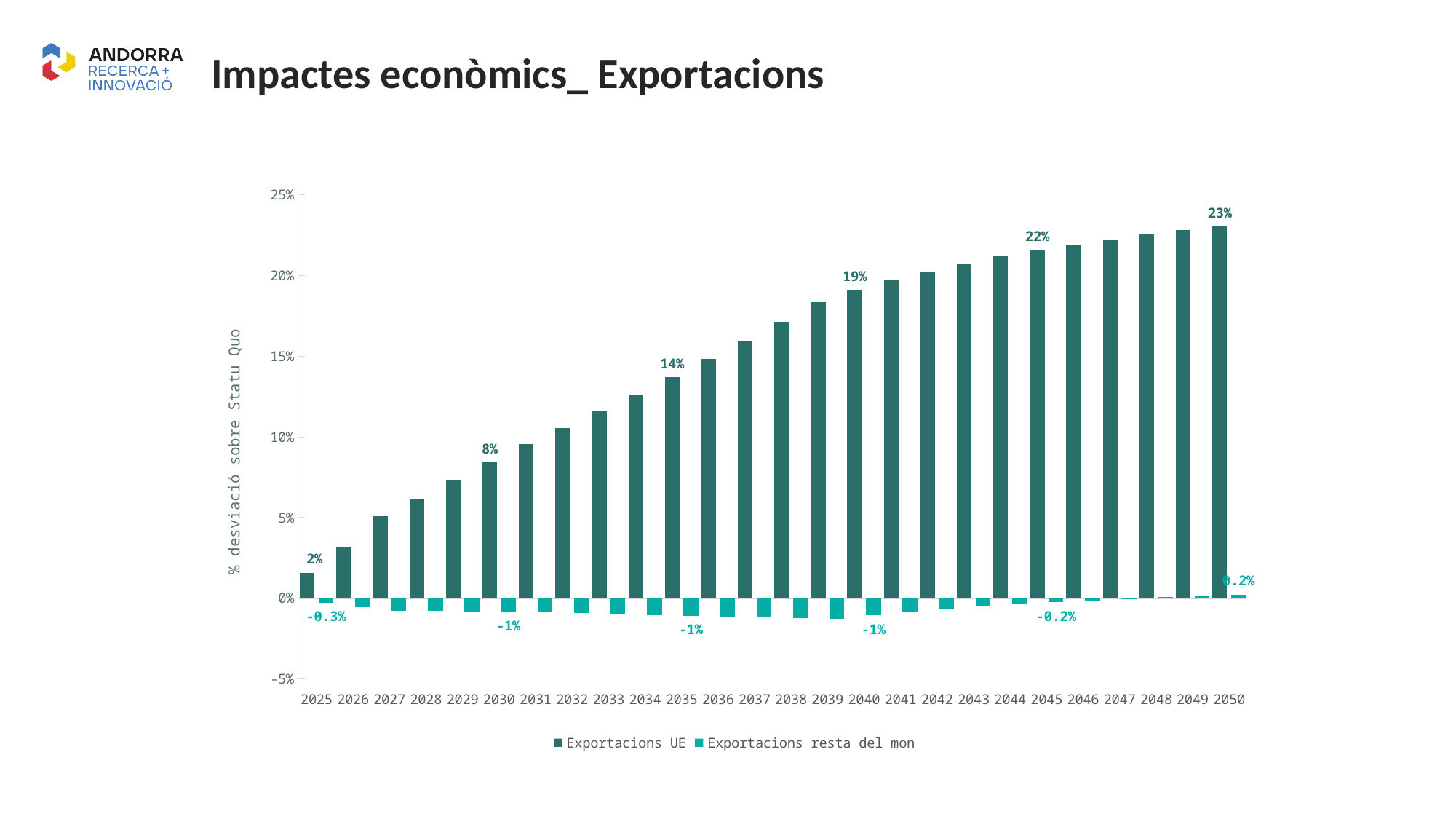
What is the value for Exportacions UE in 2035? 14% How many years are shown on the x axis? 26 Is the value for Exportacions UE in 2033 greater or less than 10%? greater What is the value for Exportacions UE in 2050? 23% Which year has the larger Exportacions UE value, 2030 or 2040? 2040 What is the value for Exportacions resta del mon in 2050? 0.2% Does the Exportacions UE series rise or fall from 2025 to 2050? rise What is the value for Exportacions resta del mon in 2025? -0.3% In which year is Exportacions UE highest? 2050 What is the difference between the Exportacions UE value in 2050 and in 2025? 21% In which year is Exportacions UE lowest? 2025 How many series does the legend list? 2